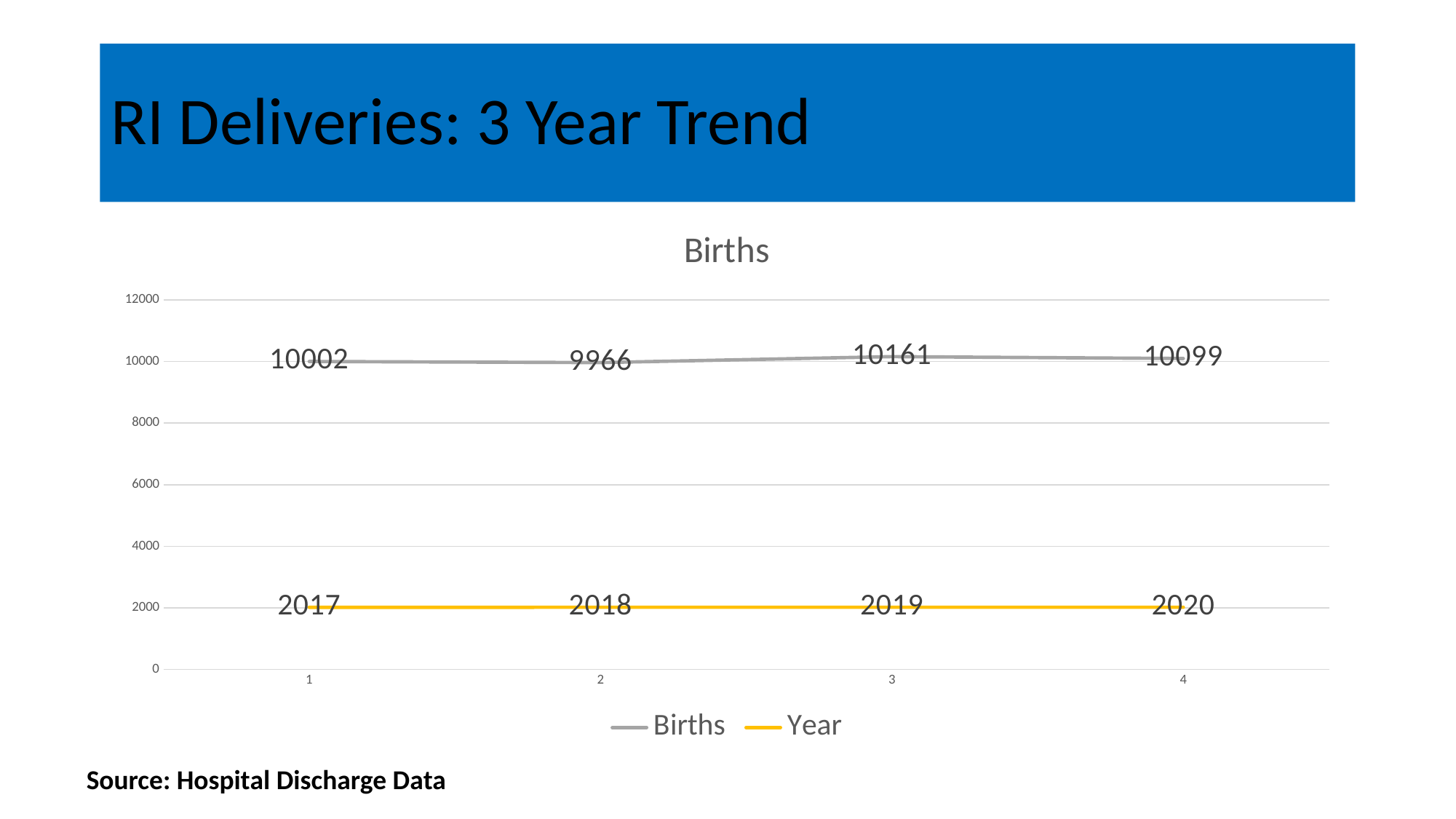
What is the Births value at x-axis category 2 (the point paired with year 2018)? 9966 Which year has the lowest Births value? 2018 How many points are plotted for the Births series? 4 Which year has the highest Births value? 2019 How many series does the legend list? 2 What are the names of the series in the legend? Births and Year What is the Births value at x-axis category 3 (the point paired with year 2019)? 10161 What is the title of the chart? Births What is the Births value at x-axis category 4 (the point paired with year 2020)? 10099 What is the difference between the Births value for 2019 and the Births value for 2018? 195 What type of chart is shown on the slide? line chart What is the Births value at x-axis category 1 (the point paired with year 2017)? 10002